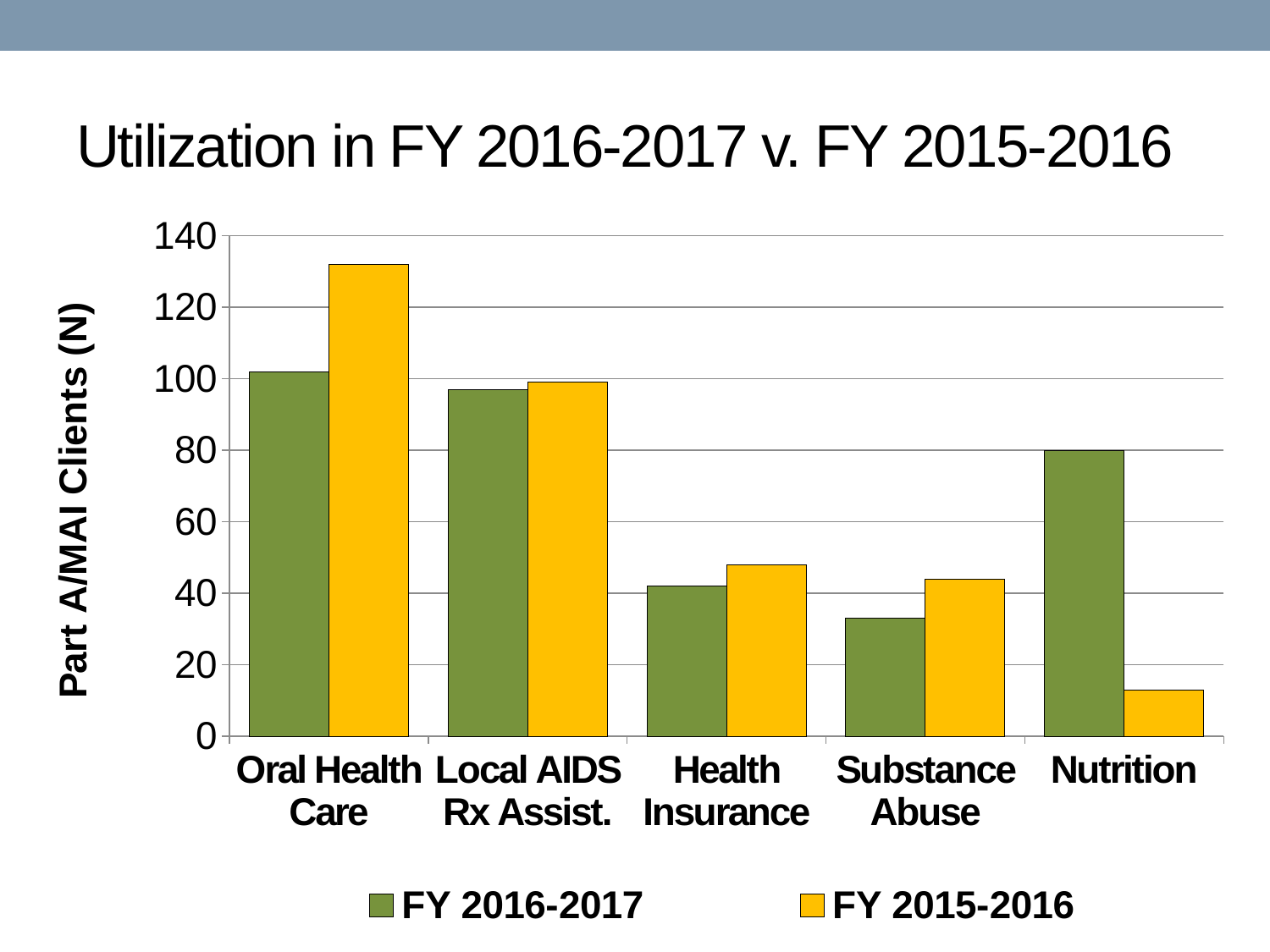
How many series does the legend list? 2 What kind of chart is shown on the slide? bar chart Which category has the highest FY 2015-2016 value? Oral Health Care Is the FY 2016-2017 value for Substance Abuse greater or less than 40? less What is the label on the vertical axis? Part A/MAI Clients (N) Is the FY 2015-2016 value for Oral Health Care greater or less than 120? greater For Nutrition, which series has the larger value, FY 2016-2017 or FY 2015-2016? FY 2016-2017 Is the FY 2015-2016 value for Nutrition greater or less than 20? less For Oral Health Care, which series has the larger value, FY 2016-2017 or FY 2015-2016? FY 2015-2016 Which category has the lowest FY 2015-2016 value? Nutrition How many categories are shown on the x axis? 5 Which category has the lowest FY 2016-2017 value? Substance Abuse